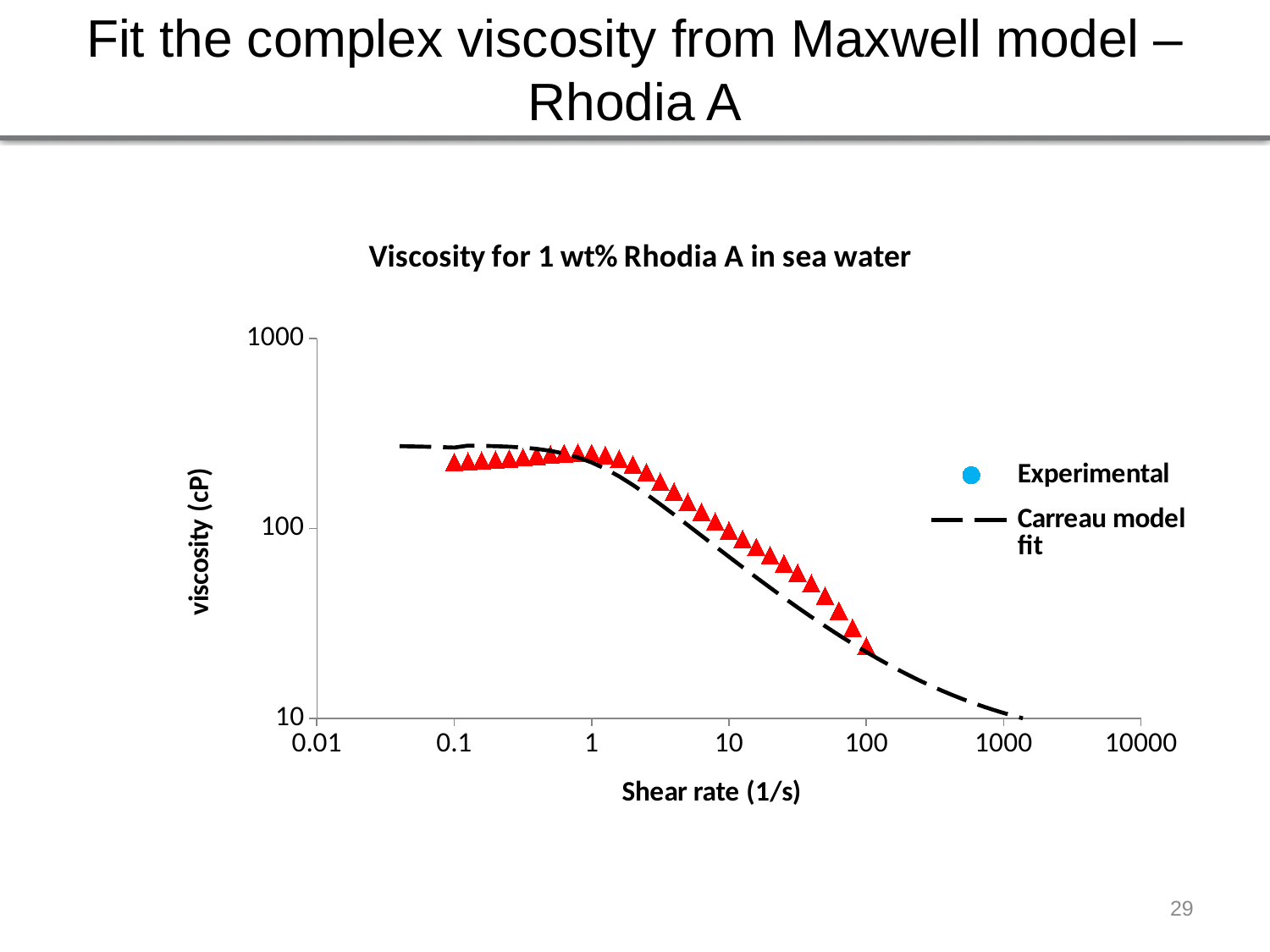
What kind of chart is shown on the slide? scatter chart with a fitted line (log-log plot) Is the Experimental viscosity at a shear rate of 1 greater or less than 1000? less Is the Experimental viscosity at a shear rate of 100 greater or less than 100? less Is the Carreau model fit viscosity at a shear rate of 100 greater or less than 100? less Does the viscosity rise or fall as the shear rate increases along the x axis? fall How many series does the legend list? 2 What is the label of the x axis? Shear rate (1/s) What is the title of the chart? Viscosity for 1 wt% Rhodia A in sea water